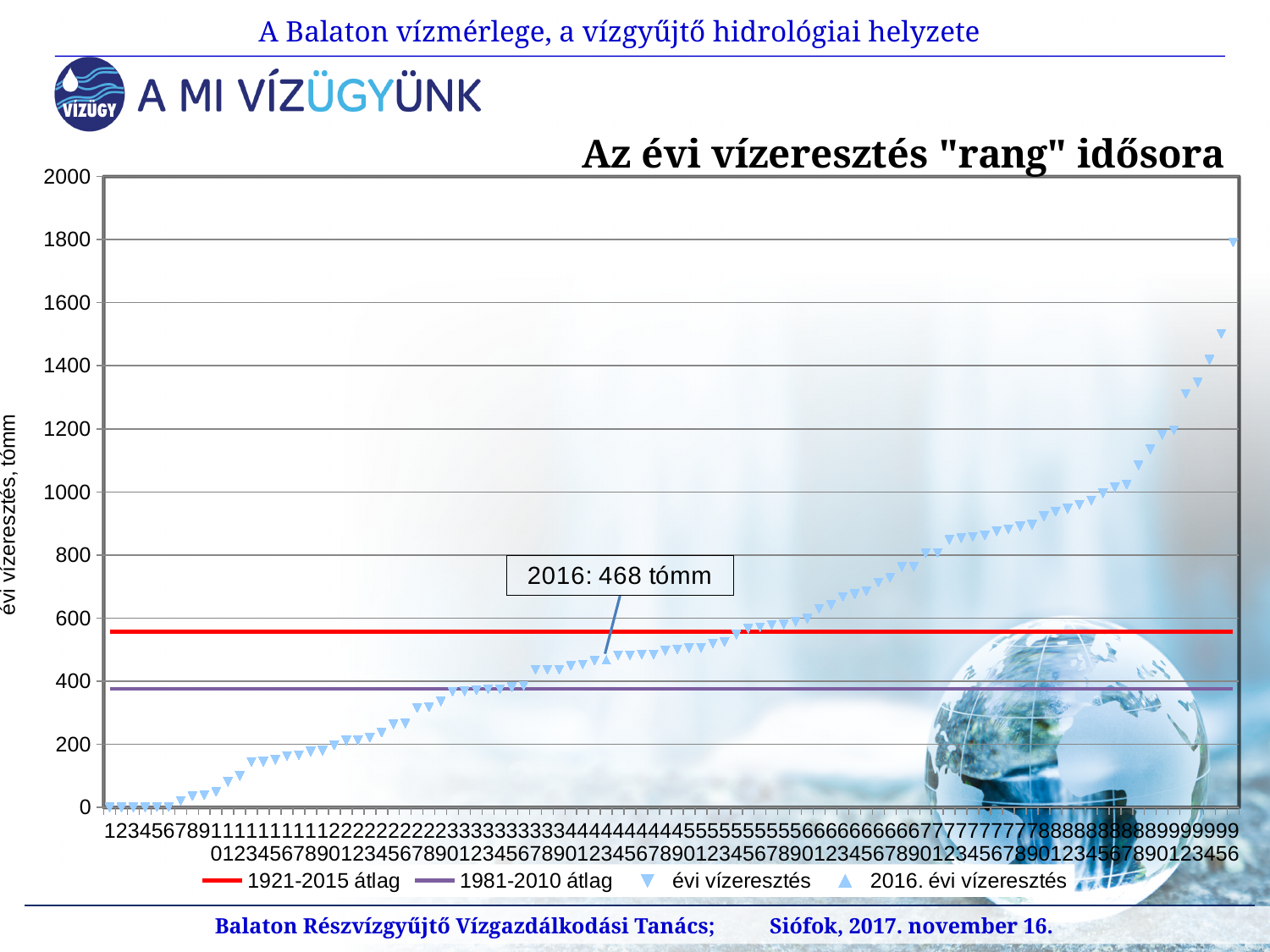
Which average line is higher, 1921-2015 átlag or 1981-2010 átlag? 1921-2015 átlag Is the 1921-2015 átlag line greater or less than 500? greater What is the title of the chart? Az évi vízeresztés "rang" idősora Is the 2016 value greater or less than the 1981-2010 átlag line? greater What is the label of the vertical axis? évi vízeresztés, tómm Is the highest évi vízeresztés point greater or less than 1600? greater Is the lowest évi vízeresztés point greater or less than 200? less What is the annotated value for 2016 on the chart? 468 tómm Is the 2016 value greater or less than the 1921-2015 átlag line? less How many series does the chart legend list? 4 Do the évi vízeresztés values rise or fall along the x axis? rise